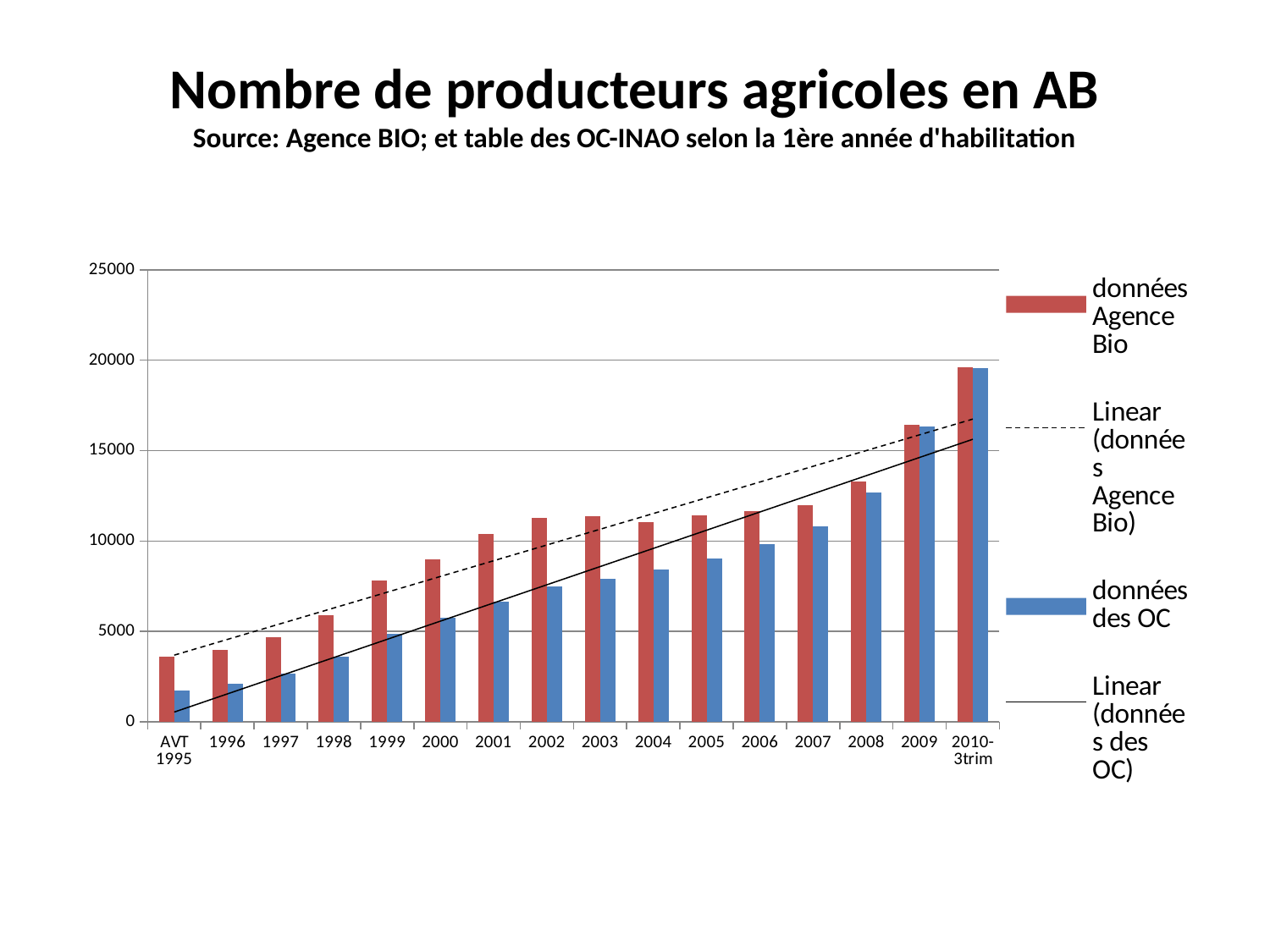
What kind of chart is shown on the slide? bar chart How many categories are shown on the x axis? 16 How many series does the legend list? 4 Is the value for données Agence Bio in 2000 greater or less than 10000? less Is the value for données des OC in 2009 greater or less than 15000? greater Is the value for données des OC in AVT 1995 greater or less than 5000? less In 2003, which series has the larger value: données Agence Bio or données des OC? données Agence Bio Which category has the highest value for données Agence Bio? 2010-3trim What is the title of the chart? Nombre de producteurs agricoles en AB Which category has the lowest value for données des OC? AVT 1995 Do the values for données des OC rise or fall from AVT 1995 to 2010-3trim? rise